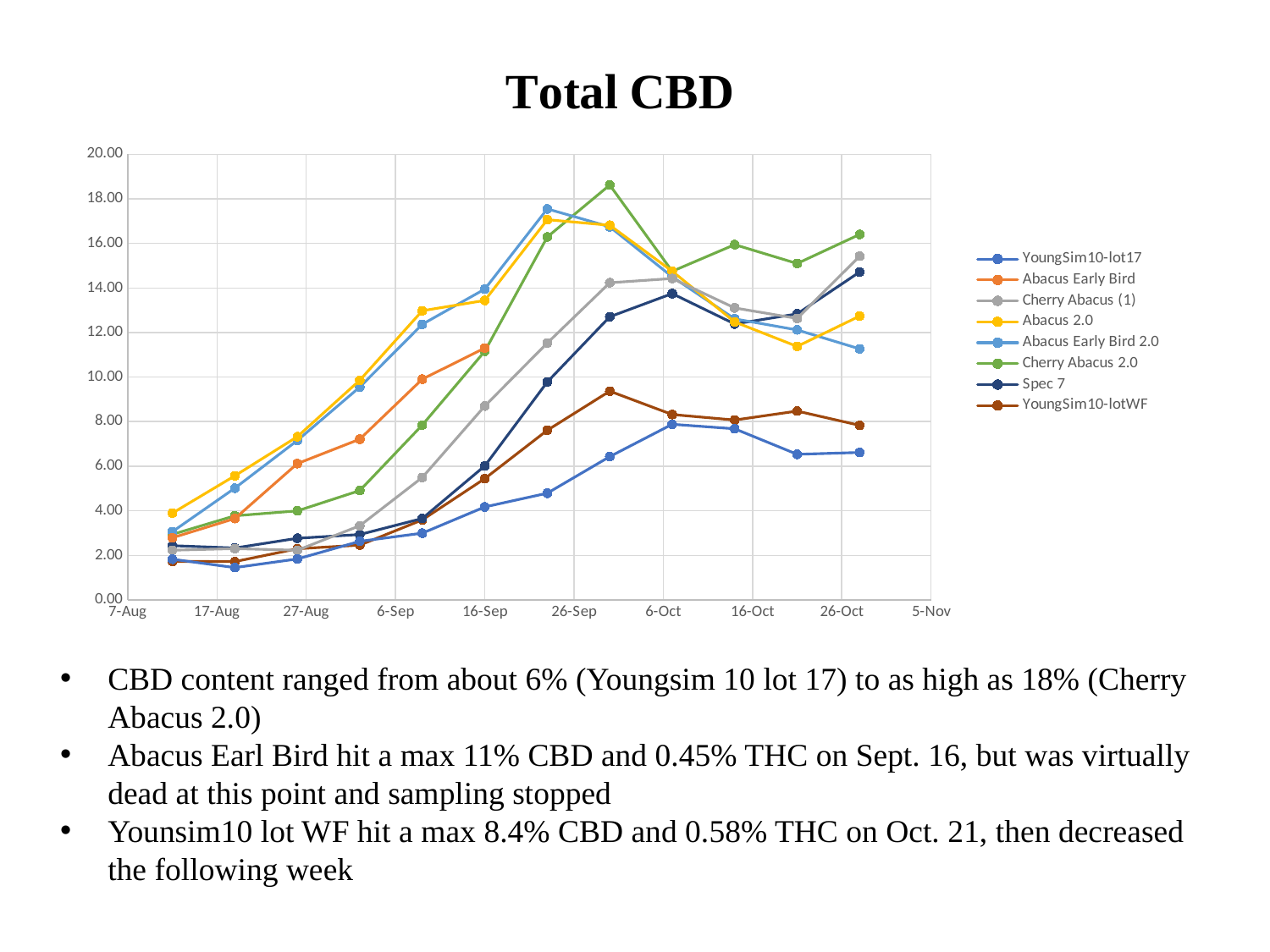
What kind of chart is shown on the slide? line chart Which series stays lowest across most of the chart? YoungSim10-lot17 Is the peak value for Cherry Abacus 2.0 greater or less than 18.00? greater Is the peak value for Abacus Early Bird 2.0 greater or less than 16.00? greater What is the title of the chart? Total CBD At the last plotted date, which is larger: Cherry Abacus 2.0 or Abacus Early Bird 2.0? Cherry Abacus 2.0 How many series does the legend list? 8 Is the peak value for YoungSim10-lotWF greater or less than 10.00? less Does the Abacus Early Bird series rise or fall from August to mid-September? rise Which series reaches the highest value on the chart? Cherry Abacus 2.0 How many date labels are shown on the x axis? 10